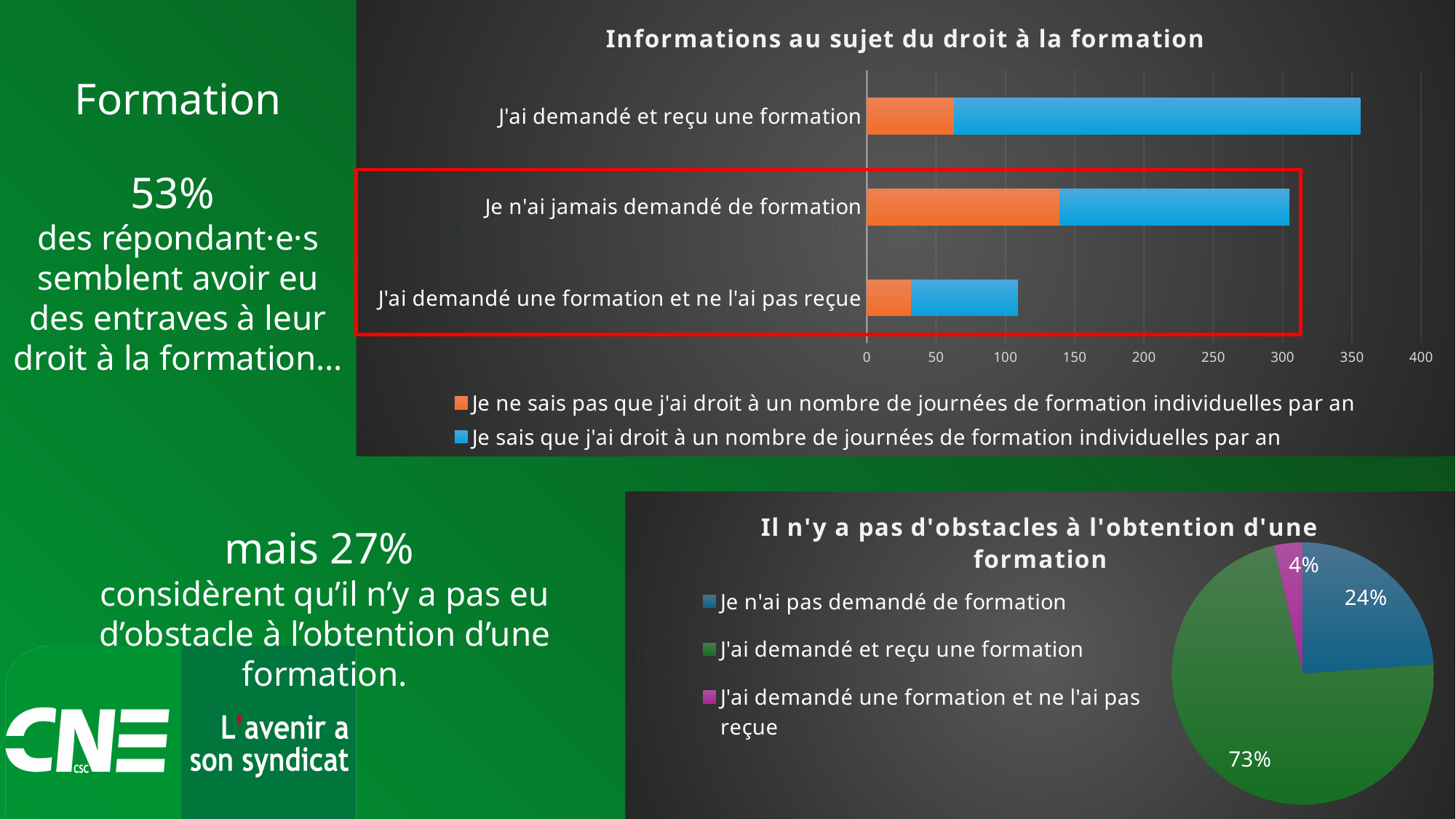
In the chart "Informations au sujet du droit à la formation", is the total value for "J'ai demandé et reçu une formation" greater or less than 300? greater In the chart "Informations au sujet du droit à la formation", is the total value for "J'ai demandé une formation et ne l'ai pas reçue" greater or less than 150? less In the pie chart "Il n'y a pas d'obstacles à l'obtention d'une formation", what is the difference in percentage points between "J'ai demandé et reçu une formation" and "Je n'ai pas demandé de formation"? 49 In the chart "Informations au sujet du droit à la formation", which category has the shortest total bar? J'ai demandé une formation et ne l'ai pas reçue What kind of chart is the chart titled "Informations au sujet du droit à la formation"? bar chart In the chart "Informations au sujet du droit à la formation", how many categories are shown? 3 In the pie chart "Il n'y a pas d'obstacles à l'obtention d'une formation", what share is "J'ai demandé et reçu une formation"? 73% In the chart "Informations au sujet du droit à la formation", which colour represents "Je sais que j'ai droit à un nombre de journées de formation individuelles par an"? blue In the pie chart "Il n'y a pas d'obstacles à l'obtention d'une formation", what share is "J'ai demandé une formation et ne l'ai pas reçue"? 4% What kind of chart is the chart titled "Il n'y a pas d'obstacles à l'obtention d'une formation"? pie chart In the chart "Informations au sujet du droit à la formation", how many series does the legend list? 2 In the chart "Informations au sujet du droit à la formation", which category has the longest total bar? J'ai demandé et reçu une formation